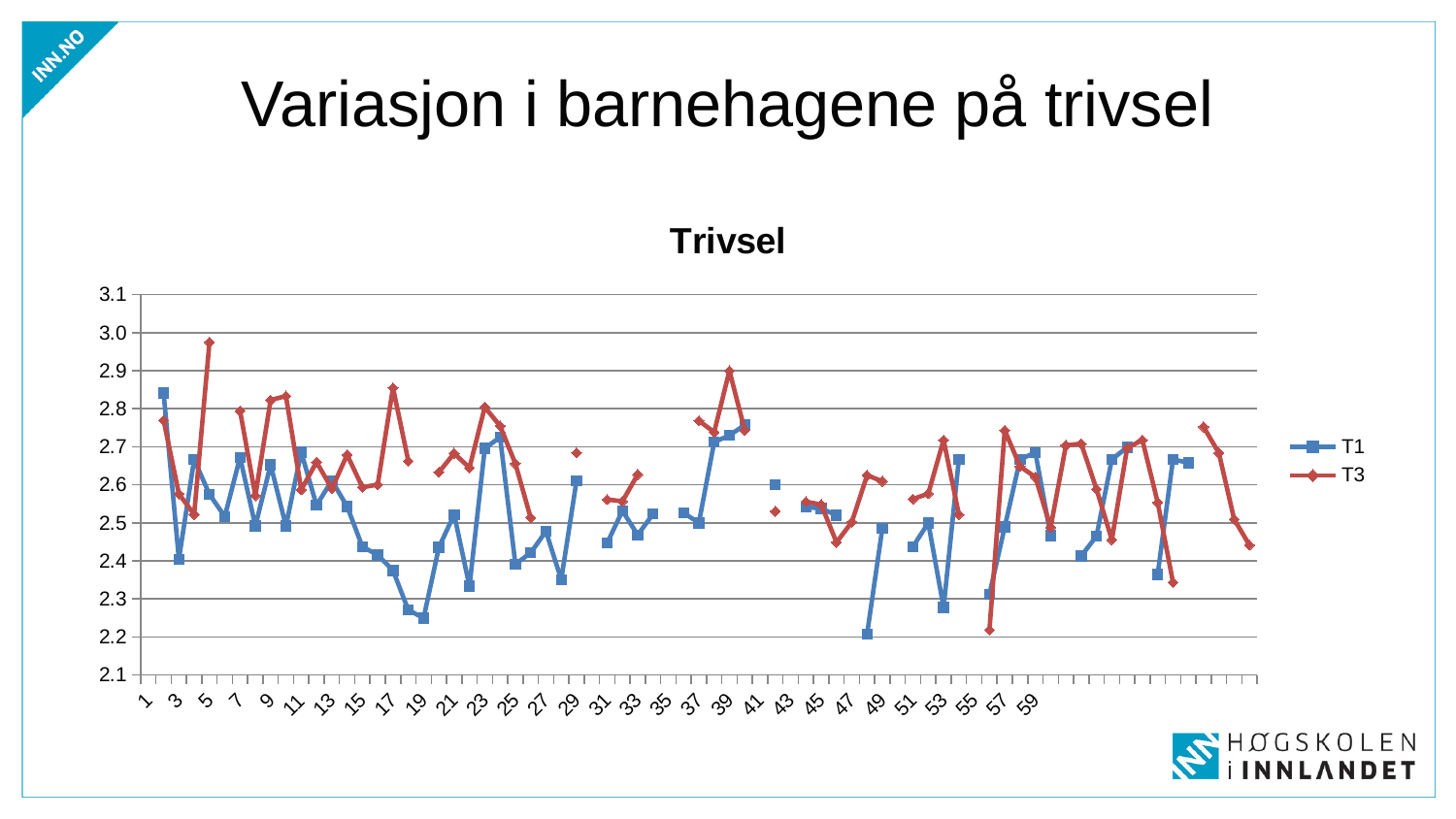
Is the value of T1 at x = 3 greater or less than 2.5? less Which series reaches the highest value anywhere on the chart? T3 What kind of chart is shown on the slide? line chart Is the value of T1 at x = 19 greater or less than 2.3? less At x = 5, which series has the larger value, T1 or T3? T3 Is the value of T3 at x = 5 greater or less than 2.9? greater What is the title of the chart? Trivsel Which series is drawn in red? T3 How many series does the legend list? 2